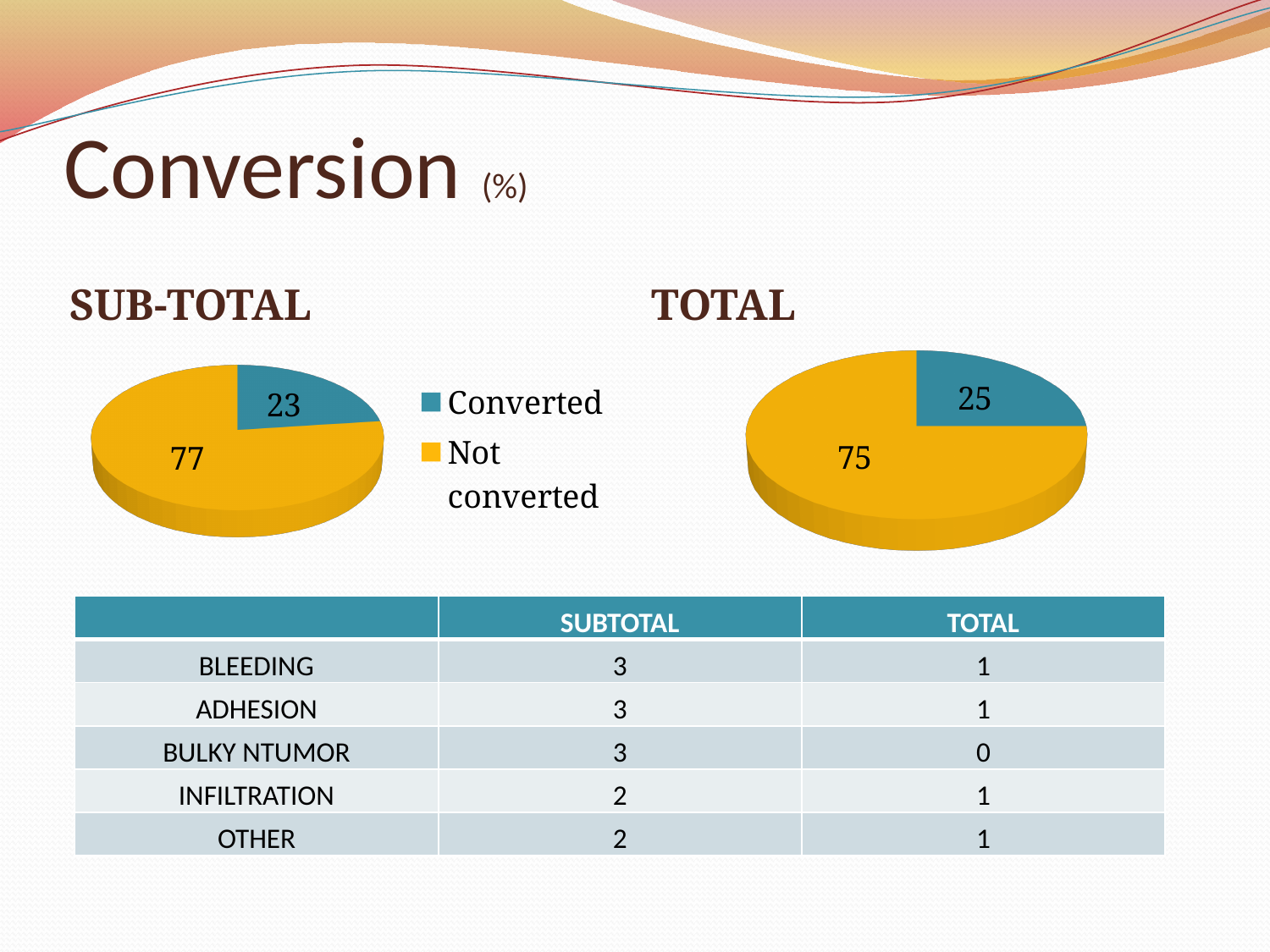
In the TOTAL pie chart, what is the value for Converted? 25 In the TOTAL pie chart, which slice is the smallest? Converted Is the Converted value larger in the SUB-TOTAL pie chart or the TOTAL pie chart? TOTAL In the SUB-TOTAL pie chart, what is the value for Converted? 23 In the TOTAL pie chart, what is the value for Not converted? 75 What type of chart is used for SUB-TOTAL and TOTAL? Pie chart In the SUB-TOTAL pie chart, which slice is the largest? Not converted In the TOTAL pie chart, what is the difference between the Not converted and Converted values? 50 How many slices does the TOTAL pie chart have? 2 In the SUB-TOTAL pie chart, what is the difference between the Not converted and Converted values? 54 In the SUB-TOTAL pie chart, what is the value for Not converted? 77 What colour is the Not converted slice in the pie charts? Yellow